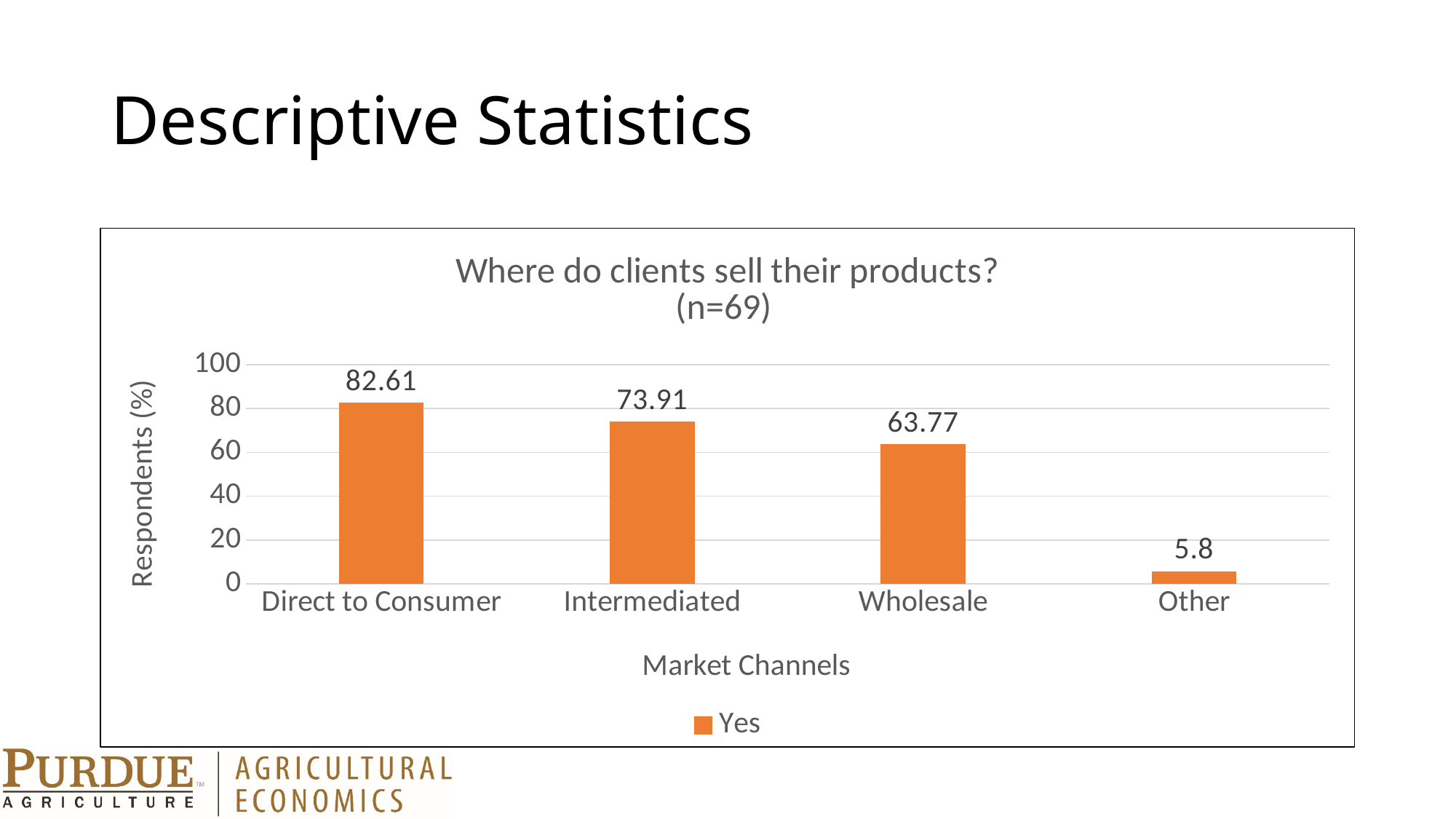
What is the title of the chart? Where do clients sell their products? (n=69) What is the value for Direct to Consumer? 82.61 What is the value for Wholesale? 63.77 Which market channel has the highest value? Direct to Consumer What is the difference between the values for Wholesale and Other? 57.97 Which market channel has the lowest value? Other What kind of chart is shown? Bar chart How many market channels are shown on the x axis? 4 Which is larger, the value for Intermediated or the value for Wholesale? Intermediated How many series does the legend list? 1 What is the value for Other? 5.8 What is the difference between the values for Direct to Consumer and Intermediated? 8.7